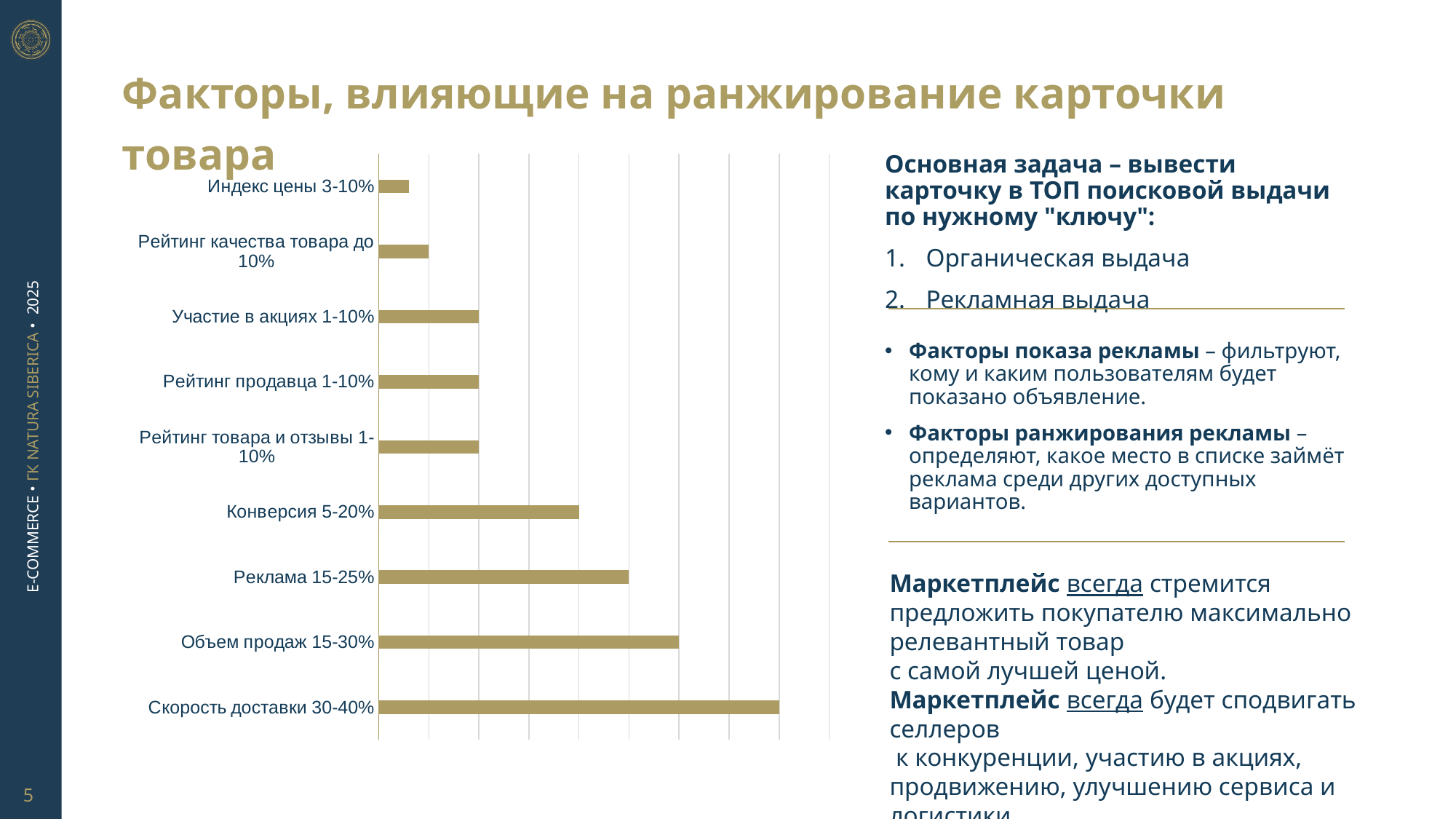
Which category has the longest bar in the chart? Скорость доставки 30-40% Which category has the shortest bar in the chart? Индекс цены 3-10% Which bar is longer: Объем продаж 15-30% or Реклама 15-25%? Объем продаж 15-30% Which category is listed at the top of the bar chart? Индекс цены 3-10% Which bar is longer: Скорость доставки 30-40% or Объем продаж 15-30%? Скорость доставки 30-40% Which bar is longer: Конверсия 5-20% or Участие в акциях 1-10%? Конверсия 5-20% What colour are the bars in the chart? Gold (tan) How many categories are plotted in the bar chart? 9 What kind of chart is shown on the slide? Bar chart